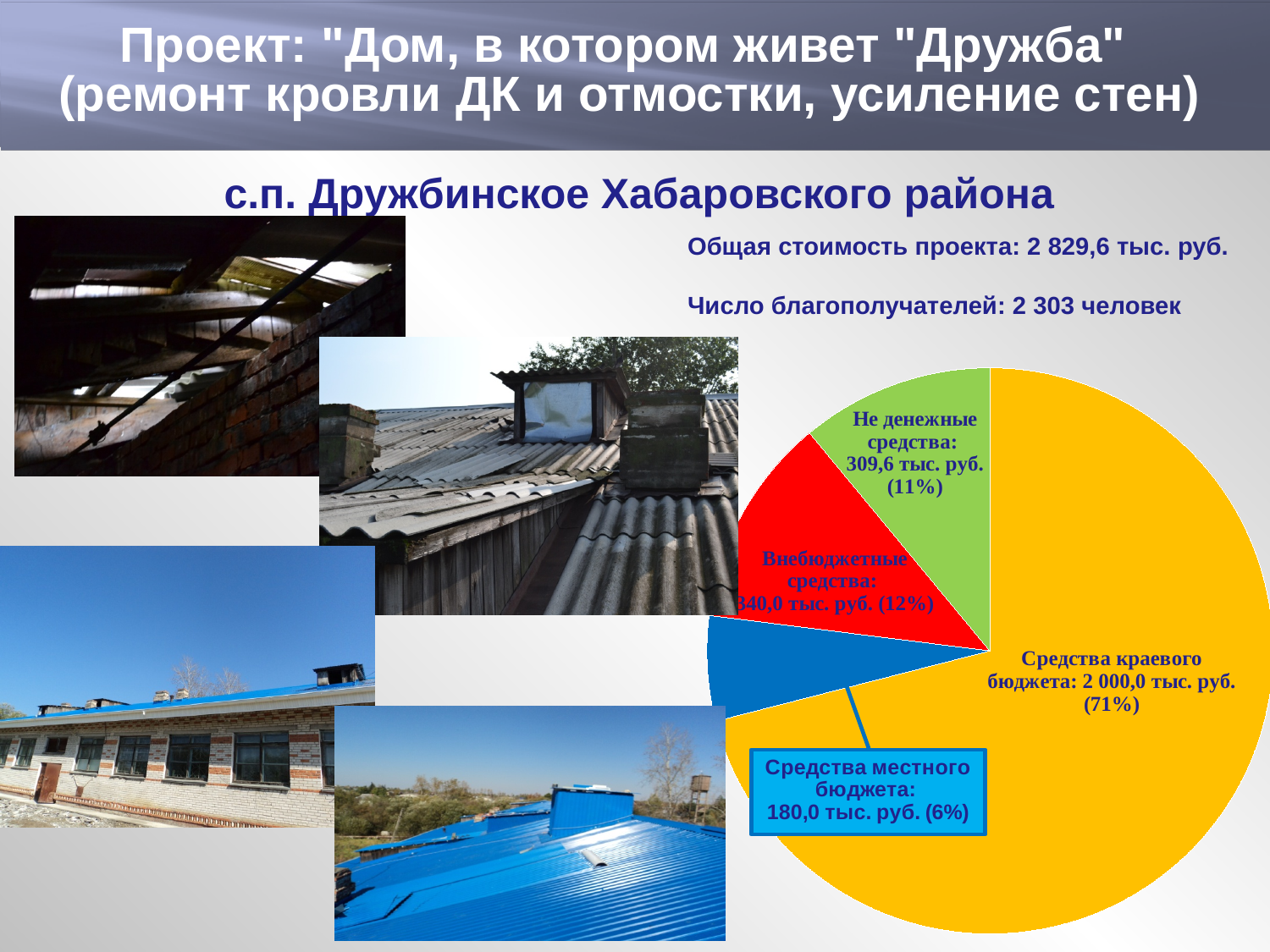
What kind of chart is shown on the slide? pie chart How many slices does the pie chart have? 4 What is the difference between Средства краевого бюджета and Средства местного бюджета? 1 820,0 тыс. руб. What is the value shown for Средства местного бюджета? 180,0 тыс. руб. Which slice of the pie chart is the smallest? Средства местного бюджета Which slice of the pie chart is the largest? Средства краевого бюджета What is the value shown for Не денежные средства? 309,6 тыс. руб. What share of the pie does Средства краевого бюджета represent? 71% What share of the pie does Средства местного бюджета represent? 6% Which is larger: Не денежные средства or Средства местного бюджета? Не денежные средства What share of the pie does Внебюджетные средства represent? 12% What is the value shown for Средства краевого бюджета? 2 000,0 тыс. руб.